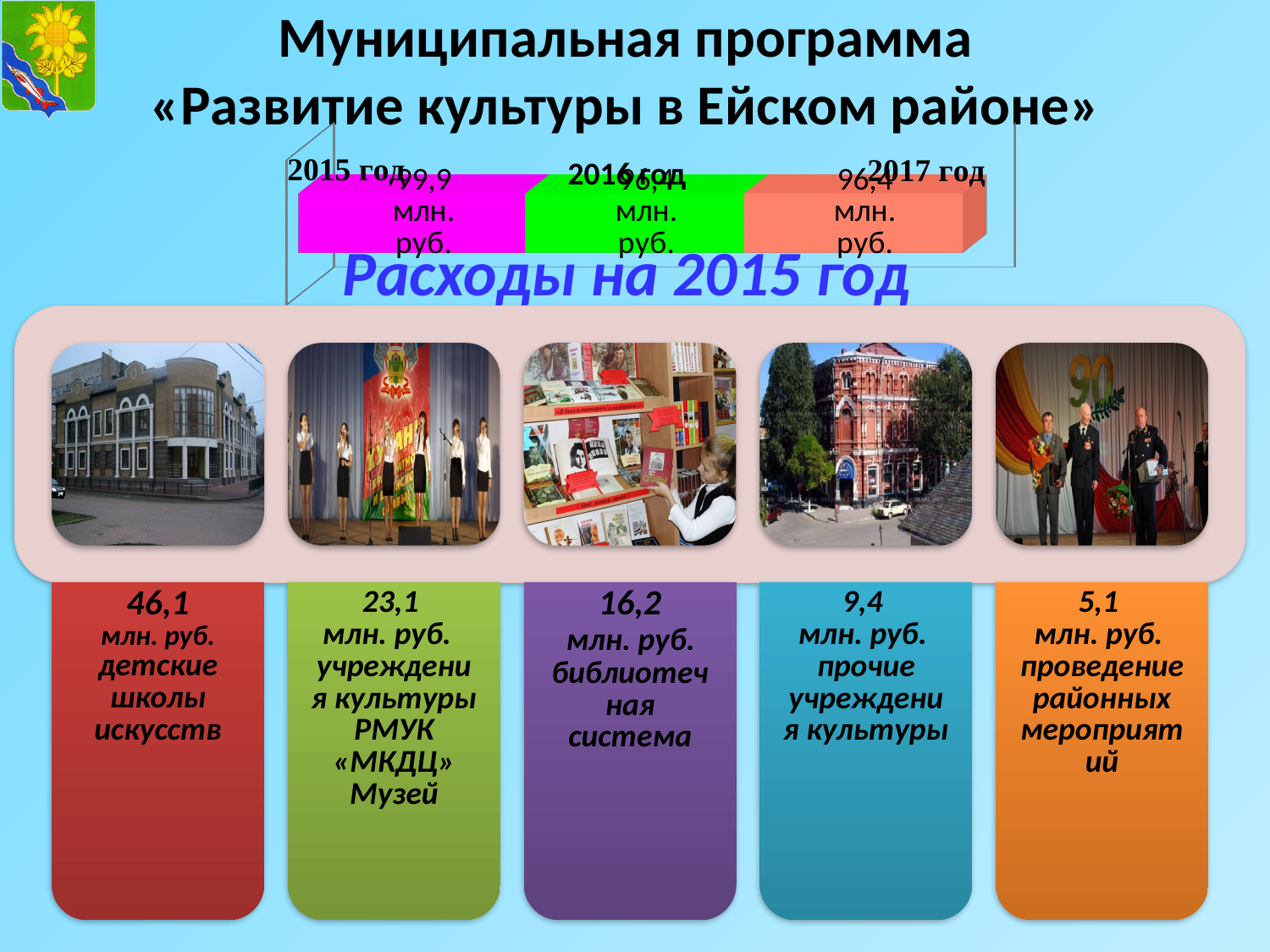
What kind of chart is used to show the values for 2015, 2016 and 2017? Bar chart What value is shown for 2017 год in the bar chart? 96,4 млн. руб. How many years (categories) does the bar chart show? 3 Which is larger in the bar chart, the value for 2015 год or the value for 2017 год? 2015 год What is the difference between the values for 2015 год and 2017 год in the bar chart? 3,5 млн. руб. Which year is the last category shown in the bar chart? 2017 год Which year is the first category shown in the bar chart? 2015 год What value is shown for 2015 год in the bar chart? 99,9 млн. руб. What colour is the bar for 2015 год? Magenta What colour is the bar for 2016 год? Green